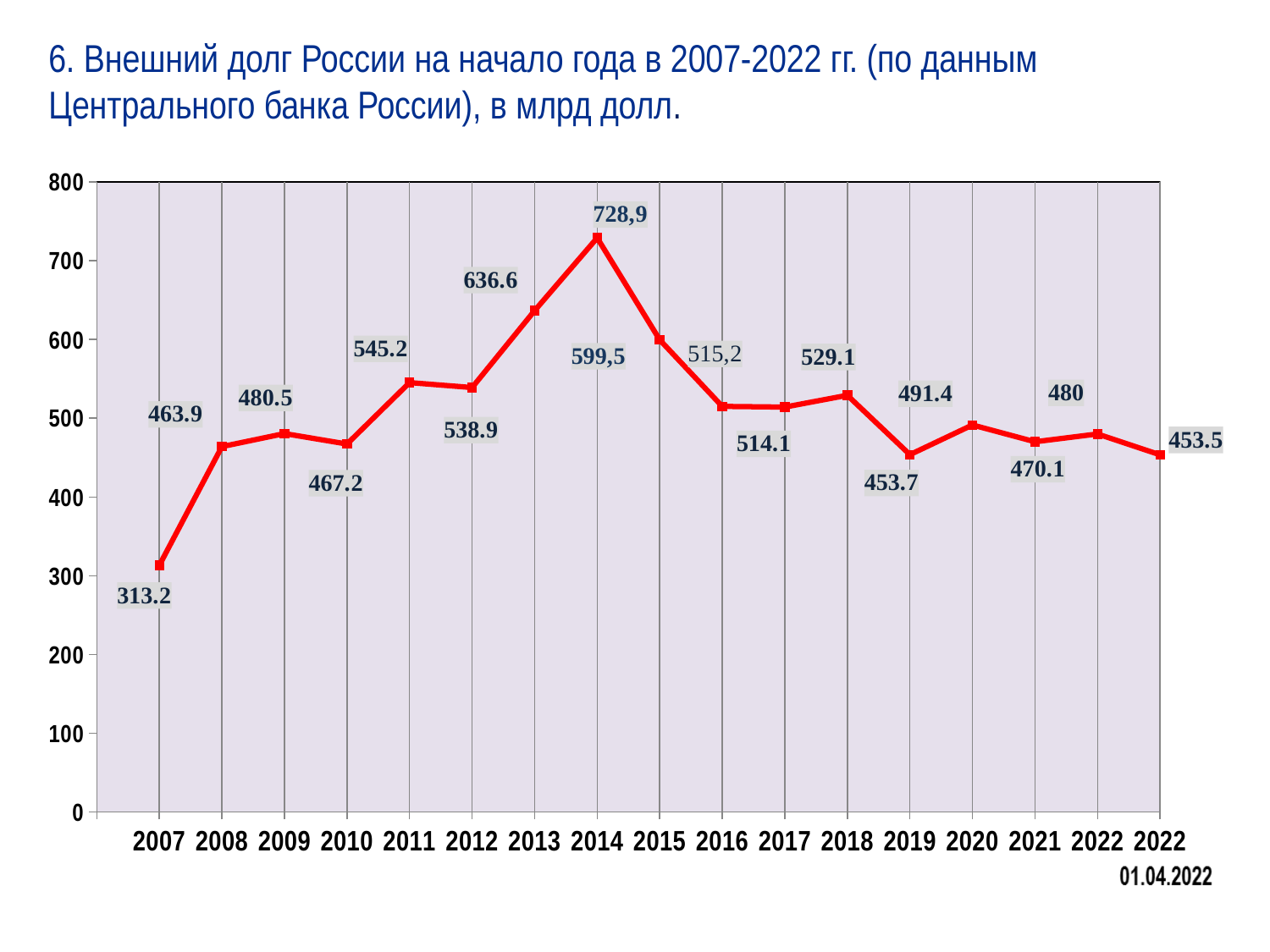
What type of chart is shown on the slide? line chart Which year has the highest value? 2014 What is the value for 2007? 313.2 What is the value for the point labelled 01.04.2022? 453.5 What is the difference between the values for 2014 and 2013? 92.3 What is the value for 2014? 728,9 What is the value for 2019? 453.7 What colour is the plotted line? red Does the value rise or fall from 2014 to 2016? fall Which is larger, the value for 2011 or the value for 2012? 2011 How many data points are plotted on the chart? 17 Which year has the lowest value? 2007